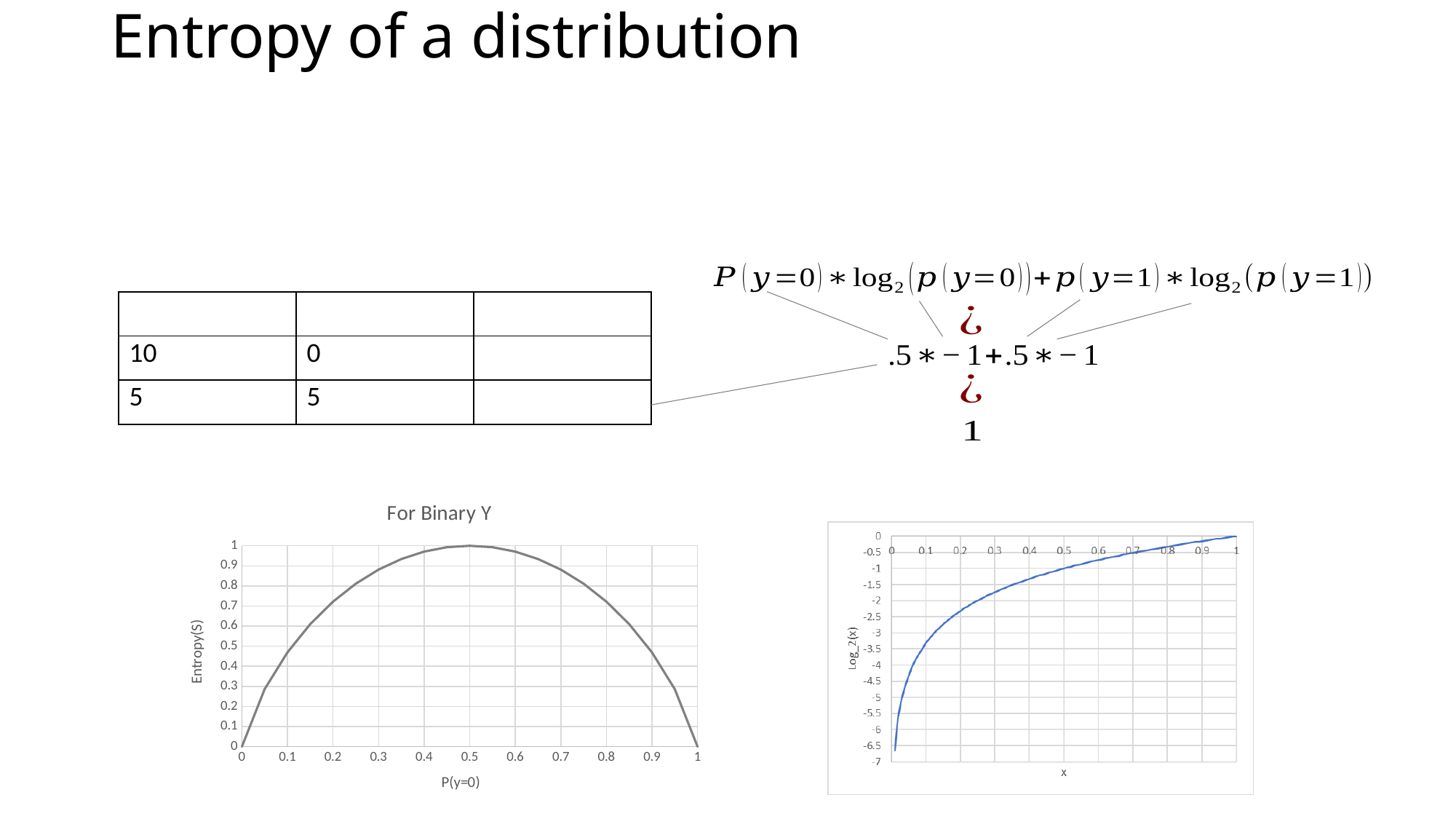
In the chart on the right of the slide, what is the value of Log_2(x) at x = 0.5? -1 In the chart on the right of the slide, is the value of Log_2(x) at x = 0.1 greater or less than -3? less In the 'For Binary Y' chart, is the value of Entropy(S) at P(y=0) = 0.1 greater or less than 0.5? less In the 'For Binary Y' chart, is the value of Entropy(S) at P(y=0) = 0.3 greater or less than 0.8? greater In the 'For Binary Y' chart, what is the value of Entropy(S) at P(y=0) = 1? 0 In the chart on the right of the slide, does Log_2(x) rise or fall as x increases? rise What is the label of the y axis of the 'For Binary Y' chart? Entropy(S) In the 'For Binary Y' chart, at which value of P(y=0) does Entropy(S) reach its highest point? 0.5 What kind of chart is the 'For Binary Y' chart? line chart In the 'For Binary Y' chart, what is the value of Entropy(S) at P(y=0) = 0.5? 1 In the 'For Binary Y' chart, does Entropy(S) rise or fall as P(y=0) increases from 0.5 to 1? fall In the chart on the right of the slide, what is the value of Log_2(x) at x = 1? 0